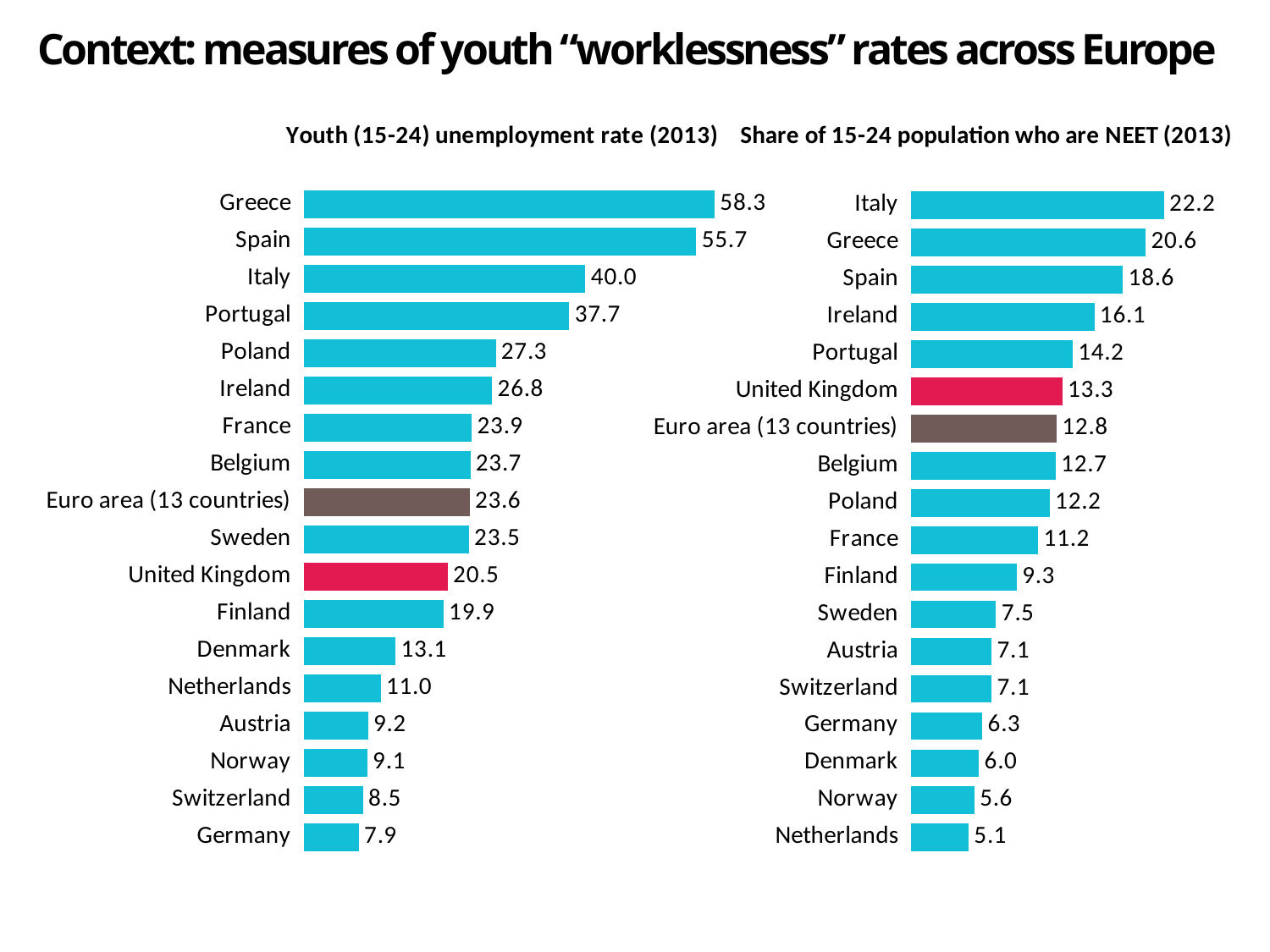
In the 'Youth (15-24) unemployment rate (2013)' chart, which country has the lowest value? Germany In the 'Share of 15-24 population who are NEET (2013)' chart, which country has the highest value? Italy In the 'Youth (15-24) unemployment rate (2013)' chart, what is the value for the Euro area (13 countries)? 23.6 In the 'Share of 15-24 population who are NEET (2013)' chart, which bar is coloured red/pink? United Kingdom In the 'Share of 15-24 population who are NEET (2013)' chart, which is larger, Sweden or Finland? Finland In the 'Youth (15-24) unemployment rate (2013)' chart, what is the difference between Spain and Italy? 15.7 In the 'Share of 15-24 population who are NEET (2013)' chart, what is the difference between Ireland and Portugal? 1.9 In the 'Share of 15-24 population who are NEET (2013)' chart, what is the value for the United Kingdom? 13.3 In the 'Youth (15-24) unemployment rate (2013)' chart, which is larger, Poland or Ireland? Poland What kind of chart is the 'Share of 15-24 population who are NEET (2013)' chart? Bar chart How many countries or areas are shown in the 'Youth (15-24) unemployment rate (2013)' chart? 18 In the 'Youth (15-24) unemployment rate (2013)' chart, what is the value for Greece? 58.3